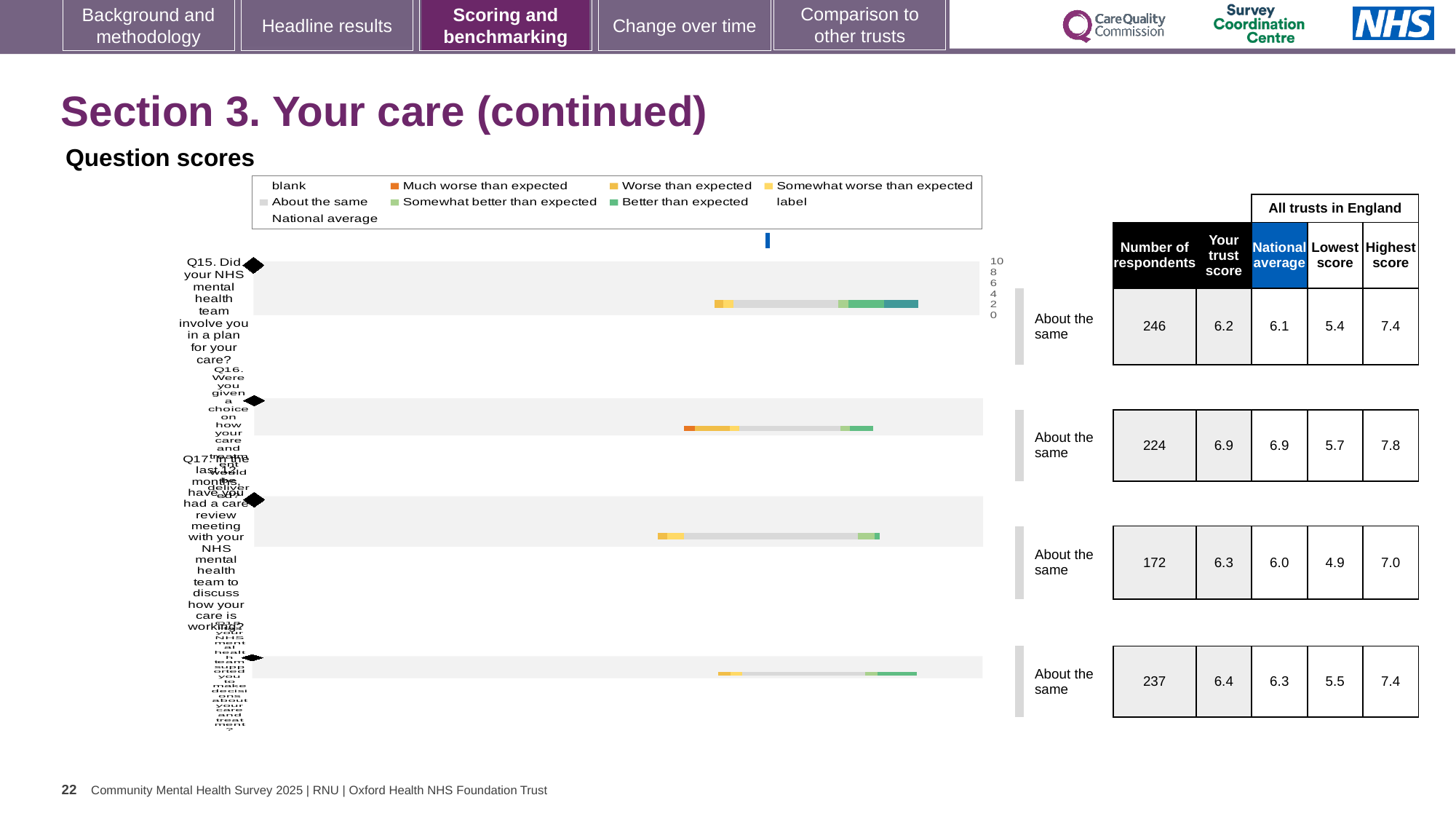
In the table beside the chart, what is the national average for Q16 (Were you given a choice on how your care and treatment would be delivered?)? 6.9 In the table beside the chart, how many respondents are listed for Q15 (Did your NHS mental health team involve you in a plan for your care?)? 246 For Q17, is the trust score or the national average higher? trust score In the table beside the chart, what is the lowest score across all trusts in England for Q17? 4.9 In the table beside the chart, what is the trust score for Q17 (care review meeting in the last 12 months)? 6.3 How many question bars are plotted in the question scores chart? 4 Which question in the table has the most respondents? Q15 In the table beside the chart, what is the highest score across all trusts in England for Q16? 7.8 What kind of chart is used to show the question scores on this slide? bar chart What is the difference between the trust score and the national average for Q15? 0.1 Which question in the table has the fewest respondents? Q17 What benchmark category is shown next to the bar for Q18 (the bottom bar)? About the same